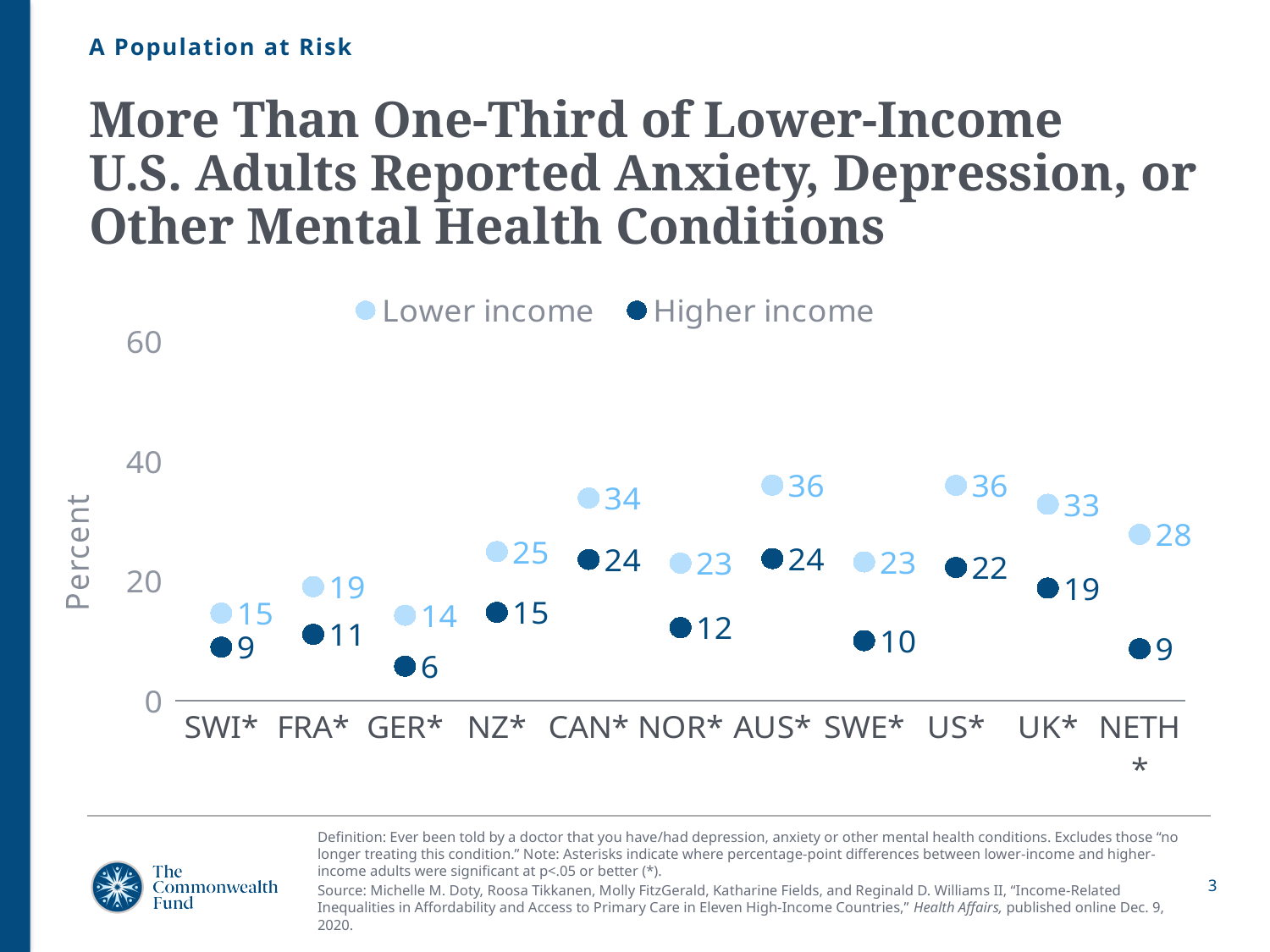
How many series does the legend list? 2 How many countries are shown on the x axis? 11 Which country has the lowest Higher income value? GER What is the difference between the Lower income and Higher income values for the Netherlands (NETH)? 19 What is the difference between the Lower income and Higher income values for the US? 14 Which country has the lowest Lower income value? GER What is the Higher income value for the UK? 19 What is the Higher income value for Germany (GER)? 6 What is the Lower income value for the US? 36 Which is larger, the Lower income value for the UK or the Lower income value for the Netherlands (NETH)? UK What kind of chart is shown on the slide? Dot plot What is the Lower income value for Canada (CAN)? 34